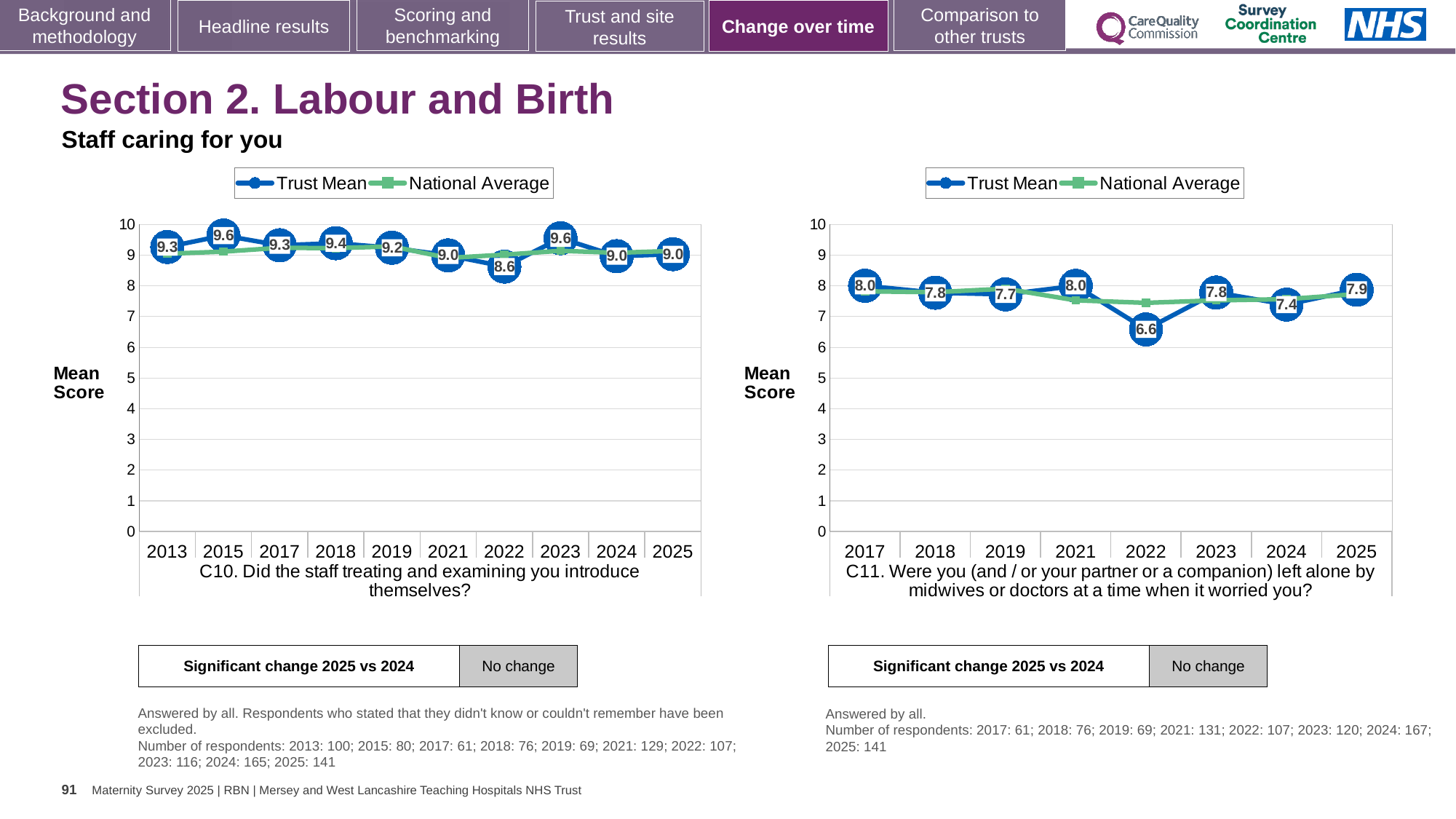
In the C11 chart, is the Trust Mean score for 2024 greater or less than the score for 2025? less In the C11 chart, what is the Trust Mean score for 2025? 7.9 In the C11 chart, what is the Trust Mean score for 2022? 6.6 In the C11 chart, what is the difference between the Trust Mean scores for 2021 and 2022? 1.4 In the C10 chart, how many years are plotted on the x axis? 10 In the C11 chart, which year has the lowest Trust Mean score? 2022 In the C10 chart, what is the Trust Mean score for 2022? 8.6 What type of chart is the C10 chart? Line chart In the C10 chart, what is the Trust Mean score for 2015? 9.6 How many series does the legend of the C11 chart list? 2 In the C10 chart, what is the difference between the Trust Mean scores for 2023 and 2022? 1.0 In the C10 chart, which year has the lowest Trust Mean score? 2022